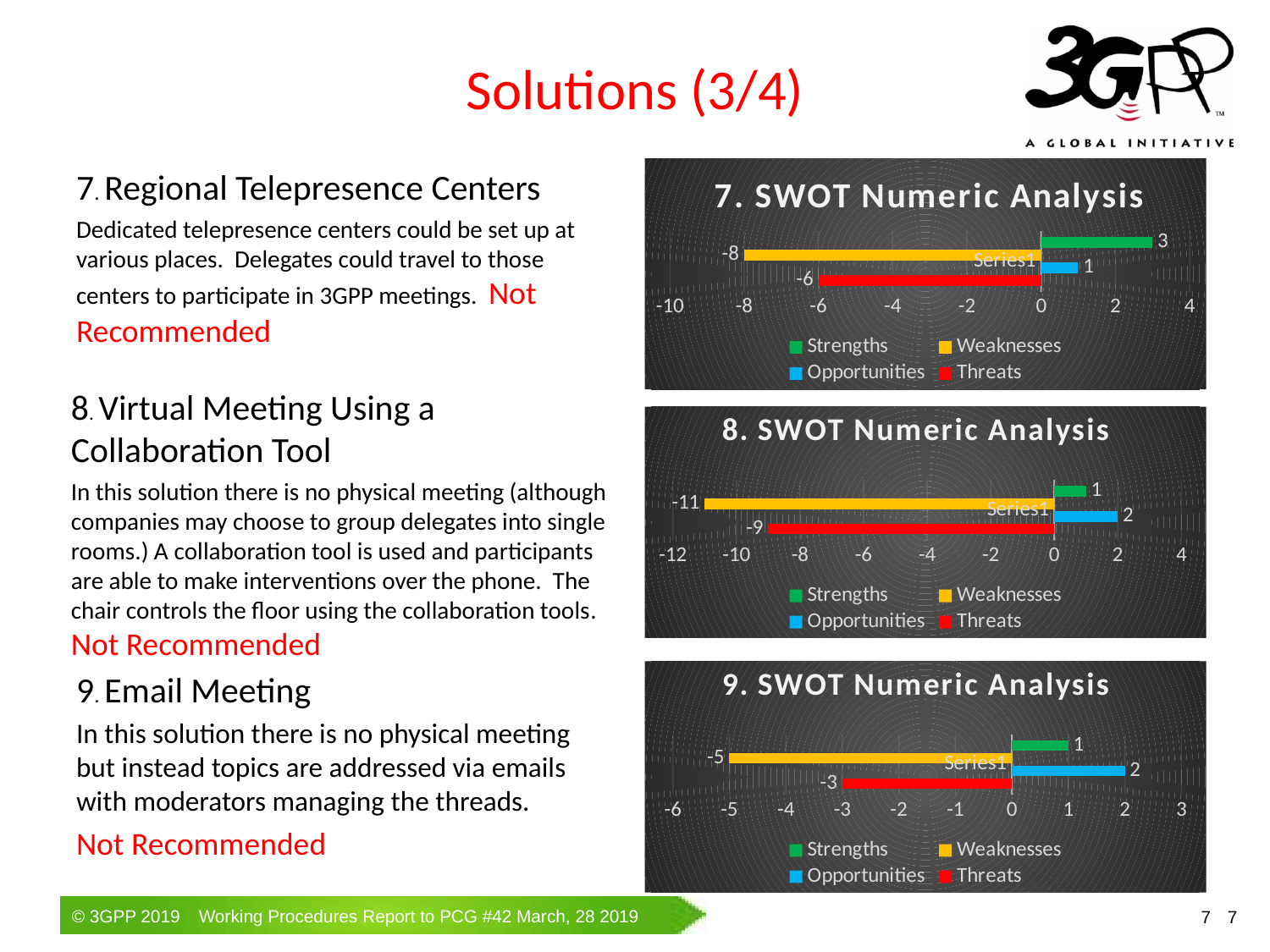
How many series does the legend of the "8. SWOT Numeric Analysis" chart list? 4 What kind of chart is the "9. SWOT Numeric Analysis" chart? Bar chart In the "7. SWOT Numeric Analysis" chart, what is the difference between the Strengths value and the Opportunities value? 2 In the "9. SWOT Numeric Analysis" chart, which is larger, the value for Strengths or the value for Opportunities? Opportunities In the "9. SWOT Numeric Analysis" chart, what is the value for Weaknesses? -5 In the "7. SWOT Numeric Analysis" chart, what is the value for Weaknesses? -8 In the "8. SWOT Numeric Analysis" chart, what is the value for Weaknesses? -11 In the "9. SWOT Numeric Analysis" chart, what is the value for Threats? -3 In the "7. SWOT Numeric Analysis" chart, what is the value for Threats? -6 In the "8. SWOT Numeric Analysis" chart, which series has the lowest value? Weaknesses In the "7. SWOT Numeric Analysis" chart, what is the value for Strengths? 3 In the "8. SWOT Numeric Analysis" chart, what is the value for Opportunities? 2